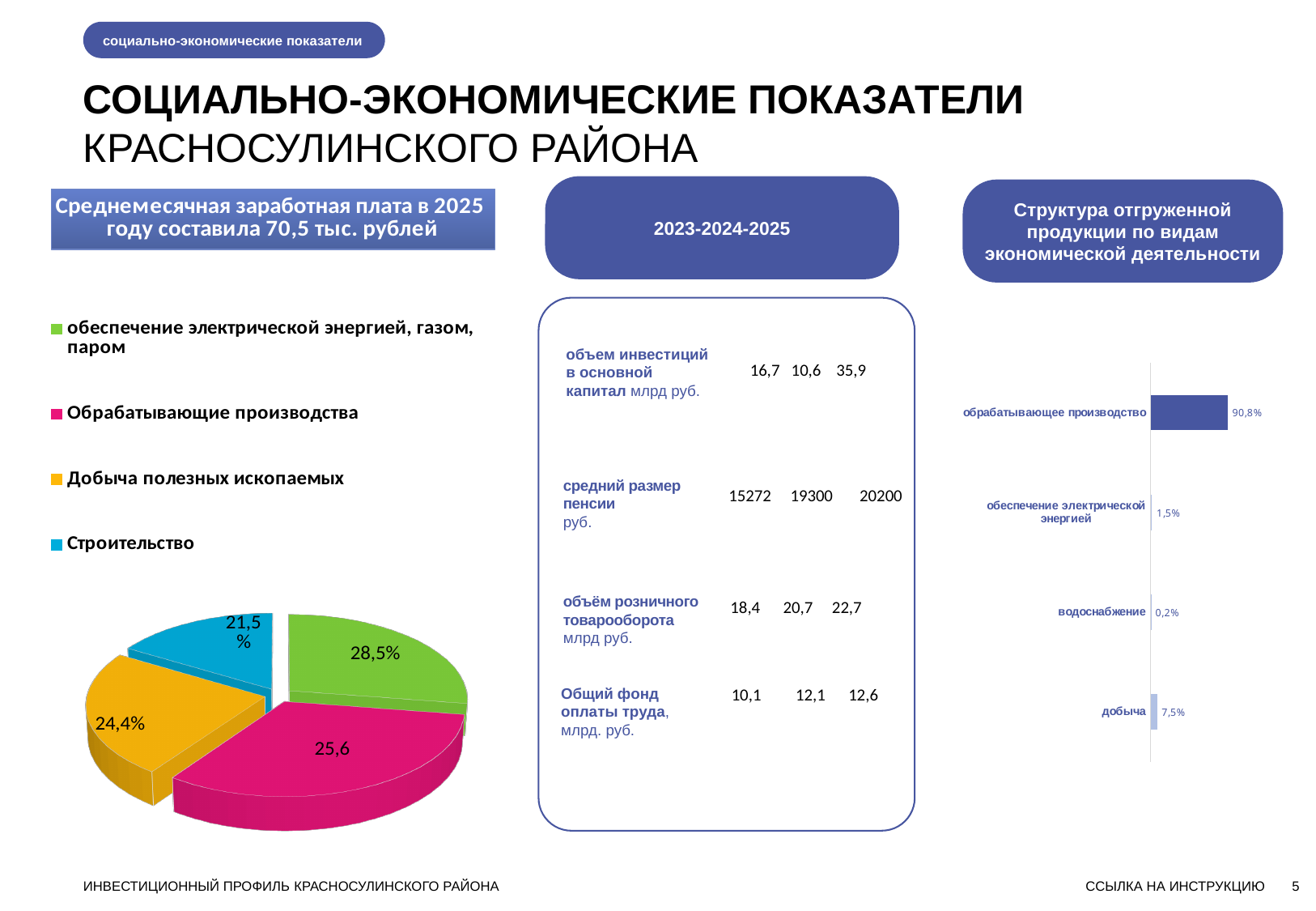
In the pie chart on the left, what share is shown for Добыча полезных ископаемых? 24,4% In the pie chart on the left, which category has the smallest slice? Строительство In the bar chart on the right (Структура отгруженной продукции), what is the value for добыча? 7,5% In the bar chart on the right (Структура отгруженной продукции), which category has the lowest value? водоснабжение How many slices does the pie chart on the left have? 4 In the pie chart on the left, what share is shown for Строительство? 21,5% In the pie chart on the left, what share is shown for the green slice (обеспечение электрической энергией, газом, паром)? 28,5% In the pie chart on the left, what value is labelled on the pink slice (Обрабатывающие производства)? 25,6 In the bar chart on the right (Структура отгруженной продукции), what is the value for водоснабжение? 0,2% In the bar chart on the right (Структура отгруженной продукции), what is the value for обрабатывающее производство? 90,8% What type of chart is the chart on the right (Структура отгруженной продукции)? bar chart